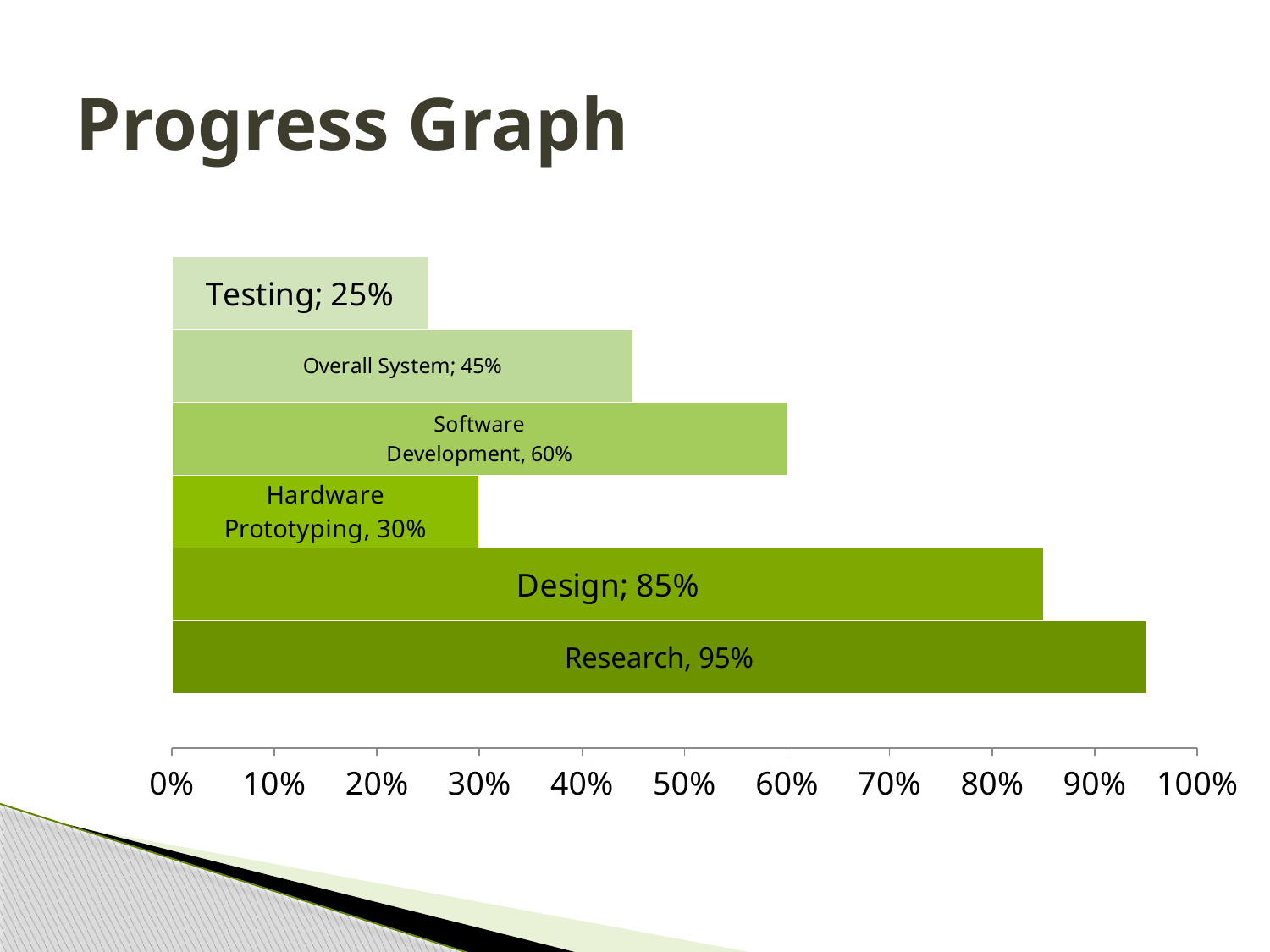
Which category has the lowest value? Testing What is the value for Hardware Prototyping? 30% What is the value for Overall System? 45% Which is larger, the value for Overall System or the value for Hardware Prototyping? Overall System What is the value for Research? 95% How many categories are shown in the chart? 6 Which category has the highest value? Research What is the title of the slide? Progress Graph What kind of chart is shown on the slide? bar chart Is the value for Design greater or less than 80%? greater What is the difference between the values for Research and Testing? 70% What is the difference between the values for Design and Software Development? 25%